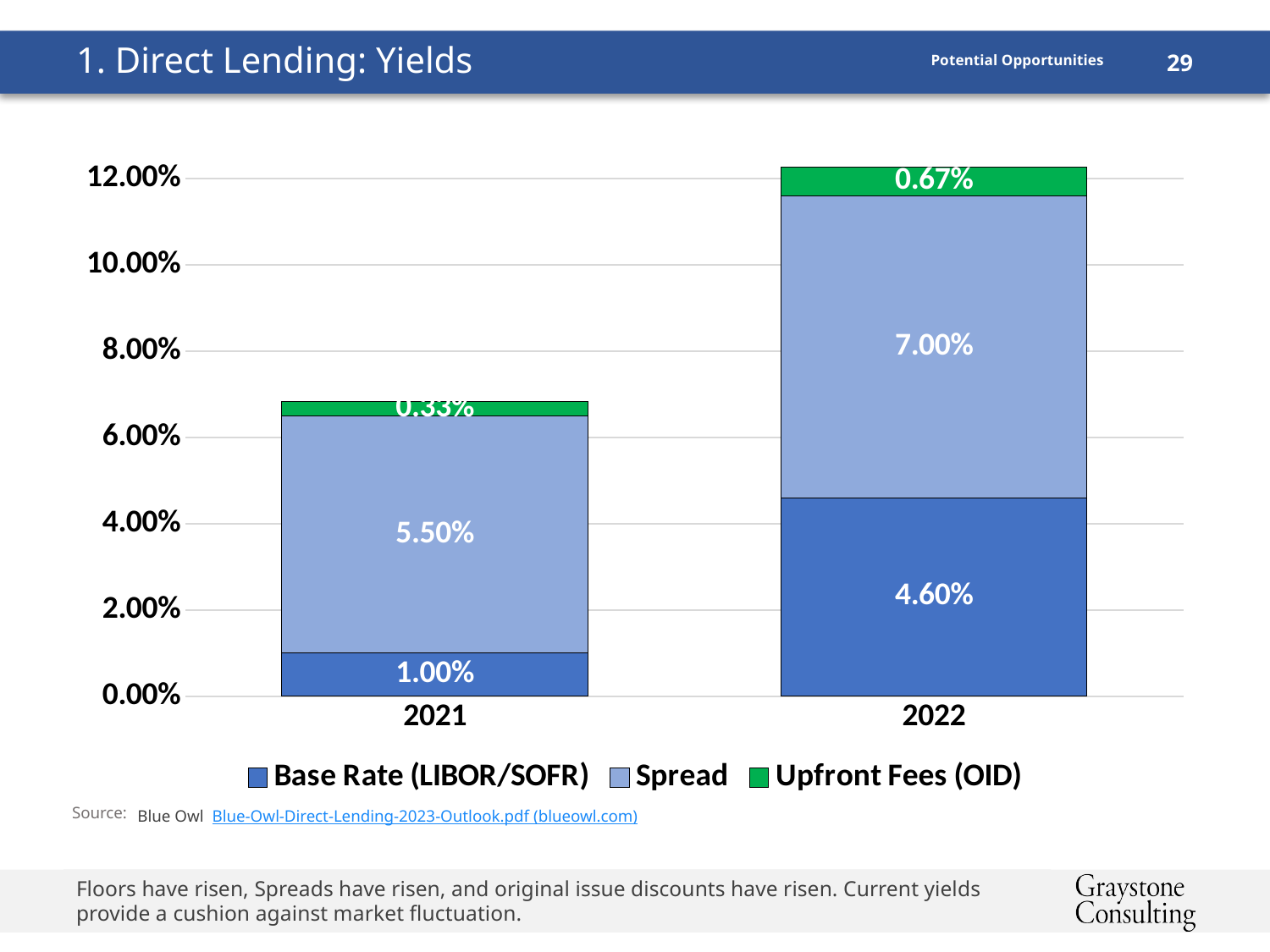
What is the Base Rate (LIBOR/SOFR) value for 2022? 4.60% Which year has the larger Base Rate (LIBOR/SOFR) value, 2021 or 2022? 2022 What is the Spread value for 2021? 5.50% What is the difference between the Spread in 2022 and the Spread in 2021? 1.50% What is the total of the stacked bar for 2022? 12.27% What is the Base Rate (LIBOR/SOFR) value for 2021? 1.00% Which colour represents Upfront Fees (OID) in the legend? Green How many years are shown on the x axis? 2 How many series does the legend list? 3 What is the Upfront Fees (OID) value for 2022? 0.67% What type of chart is shown on the slide? Stacked bar chart Is the total stacked bar for 2021 greater or less than 8.00%? less